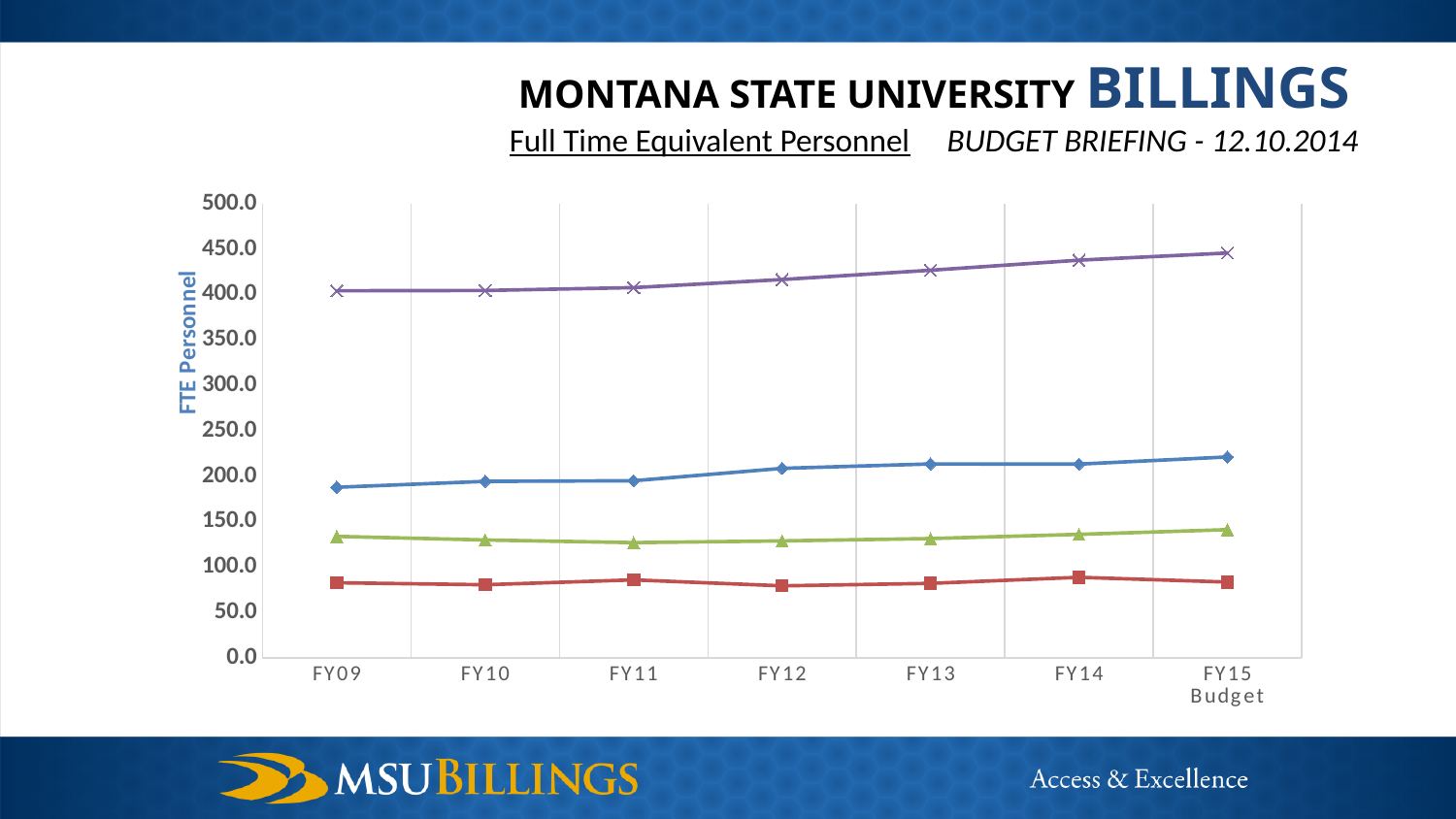
Is the value of the purple line with x markers at FY09 greater or less than 350.0? greater Which line has the lowest values across all years? the red line with square markers What is the title of the chart? Full Time Equivalent Personnel Which line has the highest values across all years: the purple line with x markers, the blue line with diamonds, the green line with triangles, or the red line with squares? the purple line with x markers Is the value of the blue line with diamond markers at FY15 Budget greater or less than 200.0? greater At FY12, which is larger: the blue line with diamond markers or the green line with triangle markers? the blue line with diamond markers What is the label on the vertical axis? FTE Personnel Is the value of the green line with triangle markers at FY11 greater or less than 150.0? less What kind of chart is shown on the slide? line chart How many fiscal-year points are plotted along the x axis? 7 Does the purple line with x markers rise or fall from FY09 to FY15 Budget? rise